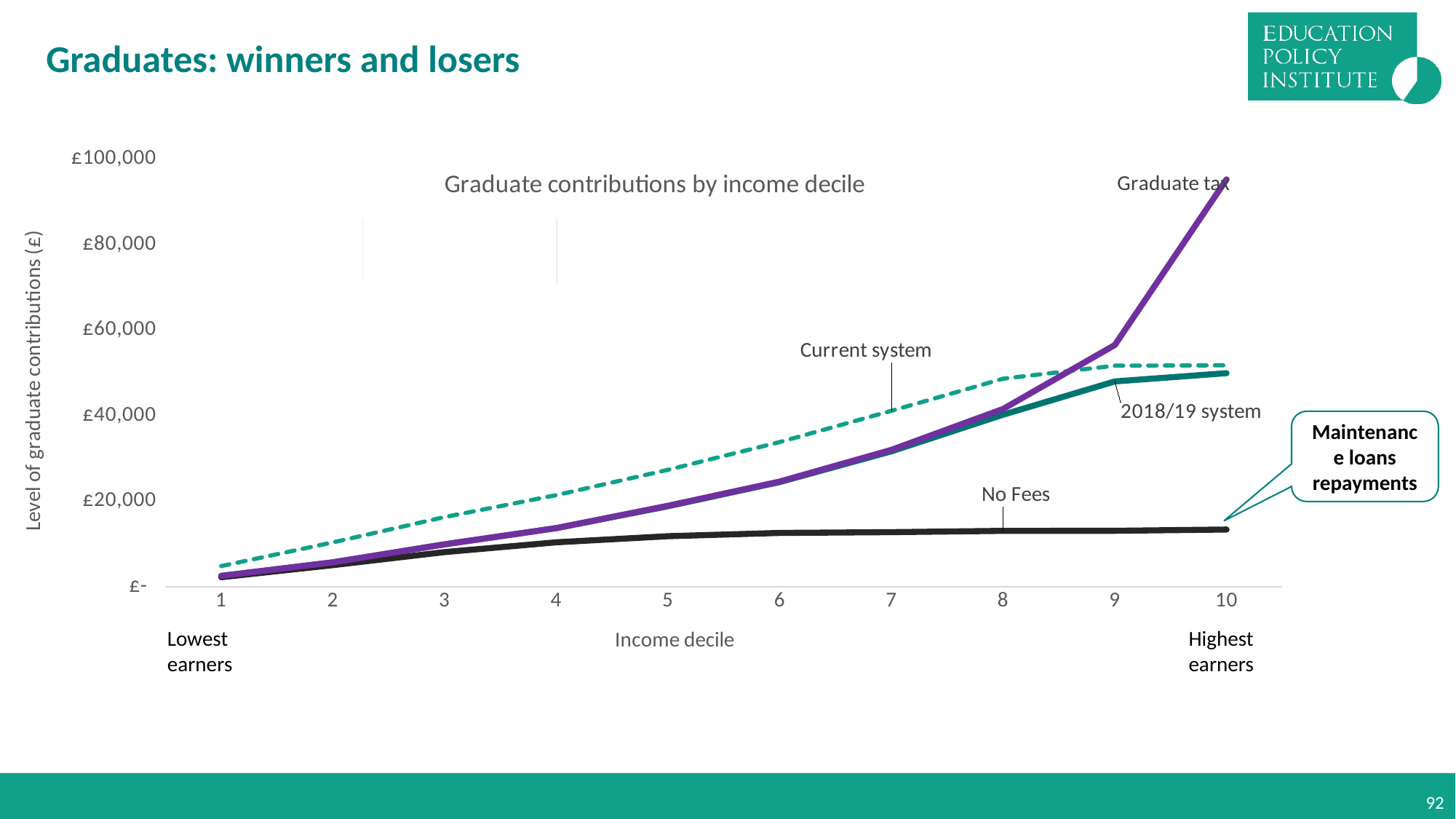
What is the title of the chart? Graduate contributions by income decile Is the Graduate tax value at income decile 10 greater or less than £80,000? greater Does the Graduate tax line rise or fall as income decile increases from 1 to 10? Rises At income decile 5, which is larger: the Current system value or the No Fees value? Current system Which series has the highest value at income decile 10? Graduate tax How many series (lines) are plotted on the chart? 4 Is the No Fees value at income decile 10 greater or less than £20,000? less What kind of chart is shown on the slide? Line chart Is the 2018/19 system value at income decile 9 greater or less than £40,000? greater How many income deciles are shown along the x axis? 10 Which series has the lowest value at income decile 10? No Fees